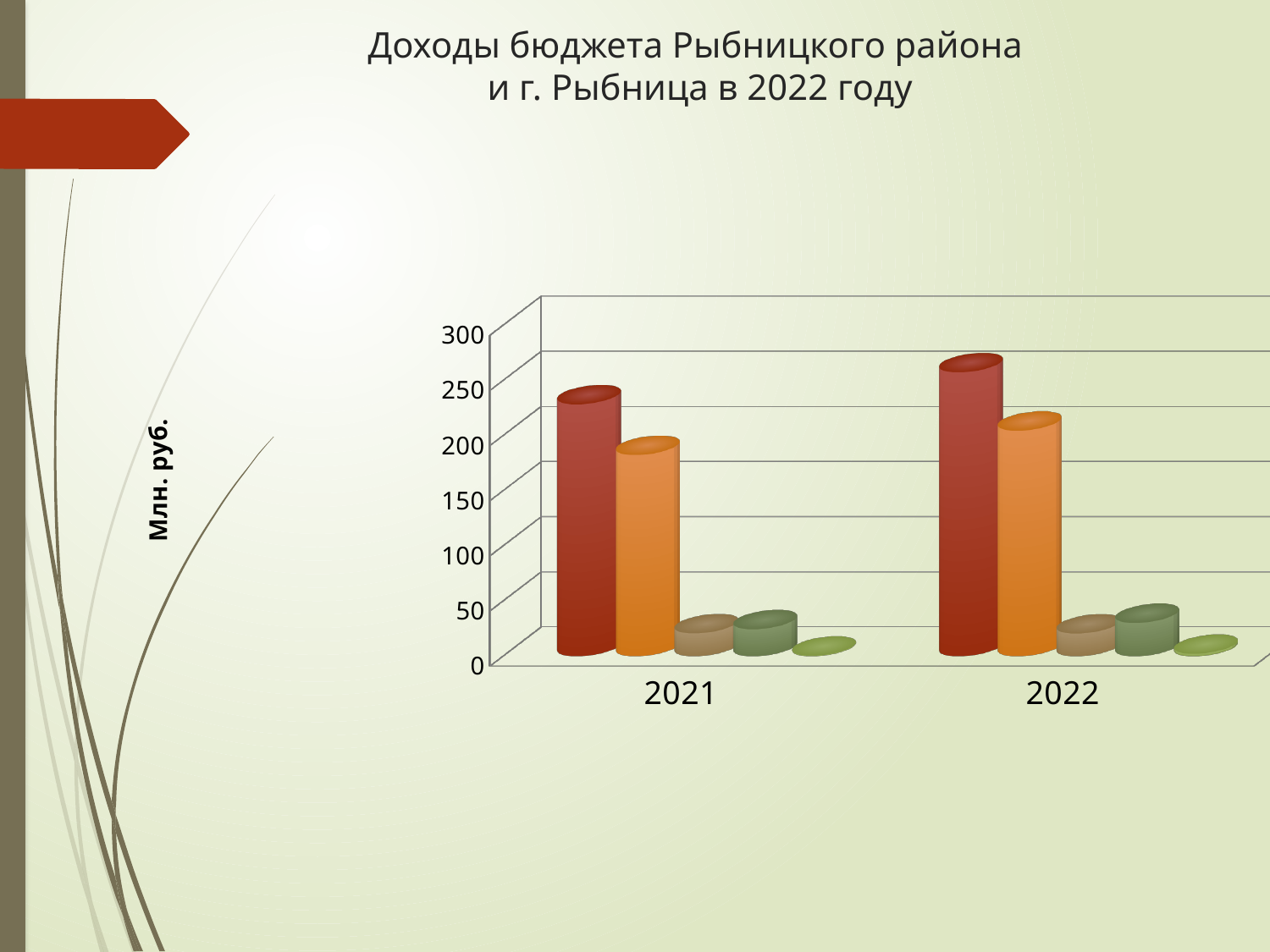
Is the value of the orange bar for 2021 greater or less than 150? greater Does the dark red bar rise or fall from 2021 to 2022? rise Is the value of the dark red bar for 2022 greater or less than 200? greater What unit is shown on the vertical axis label of the chart? Млн. руб. Is the value of the dark red bar for 2021 greater or less than 200? greater Which is larger in 2021, the dark red bar or the orange bar? the dark red bar Which coloured bar is the tallest for 2022? the dark red bar What kind of chart is shown on the slide? bar chart How many year categories are shown on the x axis of the chart? 2 What is the title of the chart on the slide? Доходы бюджета Рыбницкого района и г. Рыбница в 2022 году